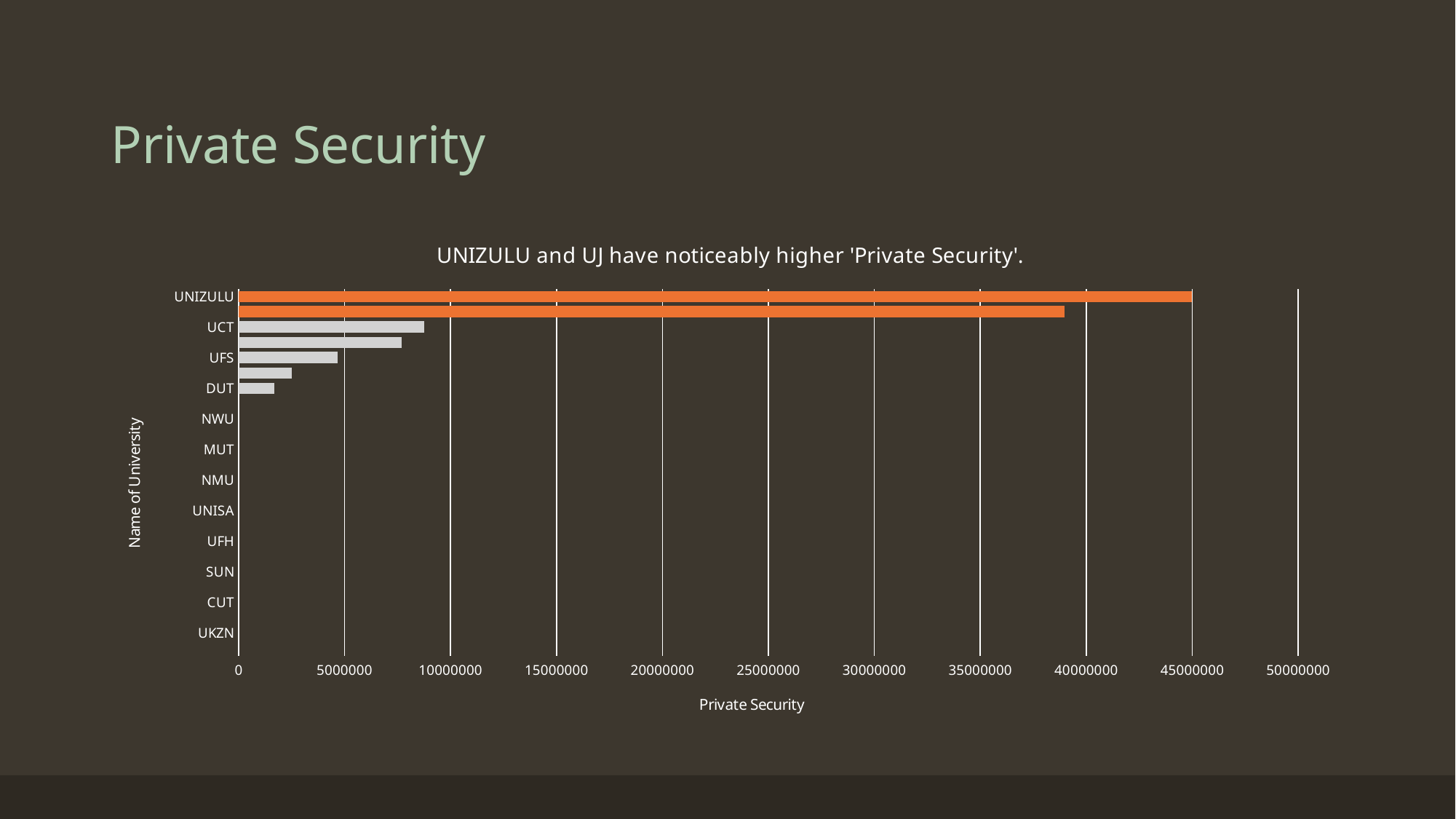
Is the value for UNIZULU greater or less than 40000000? greater Is the value for DUT greater or less than 5000000? less What kind of chart is shown on the slide? bar chart Which has the larger 'Private Security' value, DUT or UFS? UFS Is the value for UCT greater or less than 10000000? less What is the title of the chart? UNIZULU and UJ have noticeably higher 'Private Security'. What is the label on the horizontal axis of the chart? Private Security Which has the larger 'Private Security' value, UCT or UFS? UCT Which has the larger 'Private Security' value, UNIZULU or UCT? UNIZULU Which university has the highest 'Private Security' value? UNIZULU